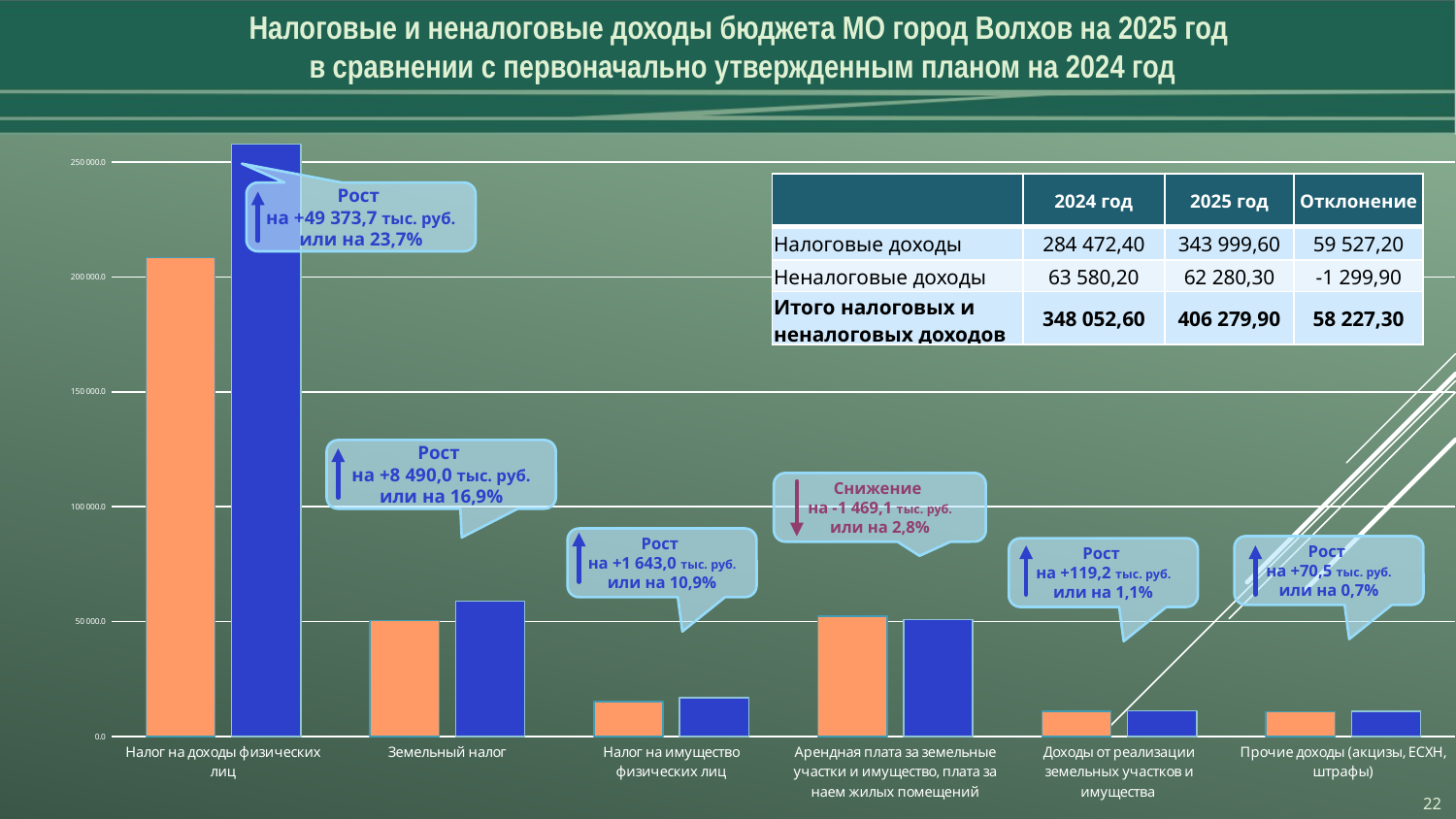
How many revenue categories are shown along the x axis of the bar chart? 6 According to the callout, what is the percentage growth for Земельный налог? 16,9% Is the value of the blue bar for Земельный налог greater or less than 50 000,0? greater Is the value of the blue bar for Налог на доходы физических лиц greater or less than 250 000,0? greater What kind of chart is shown on the slide? bar chart According to the callout, by how much does Арендная плата за земельные участки и имущество, плата за наем жилых помещений decrease in thousand rubles? -1 469,1 тыс. руб. According to the callout, by how much does Налог на доходы физических лиц grow in thousand rubles? +49 373,7 тыс. руб. Is the value of the orange bar for Налог на имущество физических лиц greater or less than 50 000,0? less Which category is the only one marked with a decrease (Снижение) callout? Арендная плата за земельные участки и имущество, плата за наем жилых помещений Which category has the tallest bars in the chart? Налог на доходы физических лиц Which category has larger bars: Земельный налог or Налог на имущество физических лиц? Земельный налог